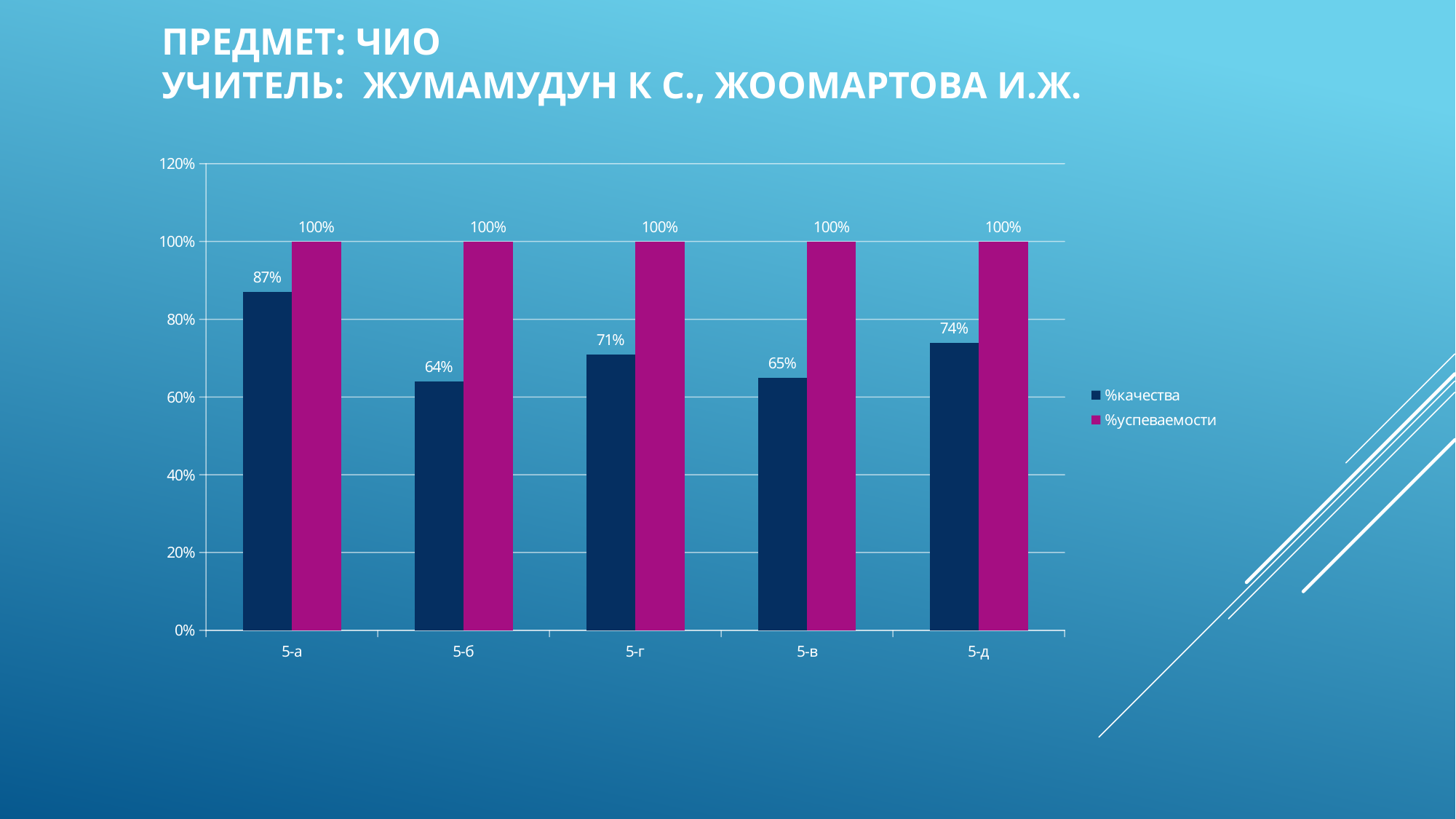
What is the %качества value for class 5-б? 64% Which is larger, the %качества value for 5-г or for 5-в? 5-г How many classes are shown on the x axis? 5 What is the %качества value for class 5-а? 87% What is the difference between the %качества values for 5-а and 5-б? 23% How many series does the legend list? 2 What is the %качества value for class 5-д? 74% What is the %успеваемости value for class 5-г? 100% What kind of chart is shown on the slide? Bar chart What colour are the %успеваемости bars? Magenta Which class has the highest %качества value? 5-а Which class has the lowest %качества value? 5-б